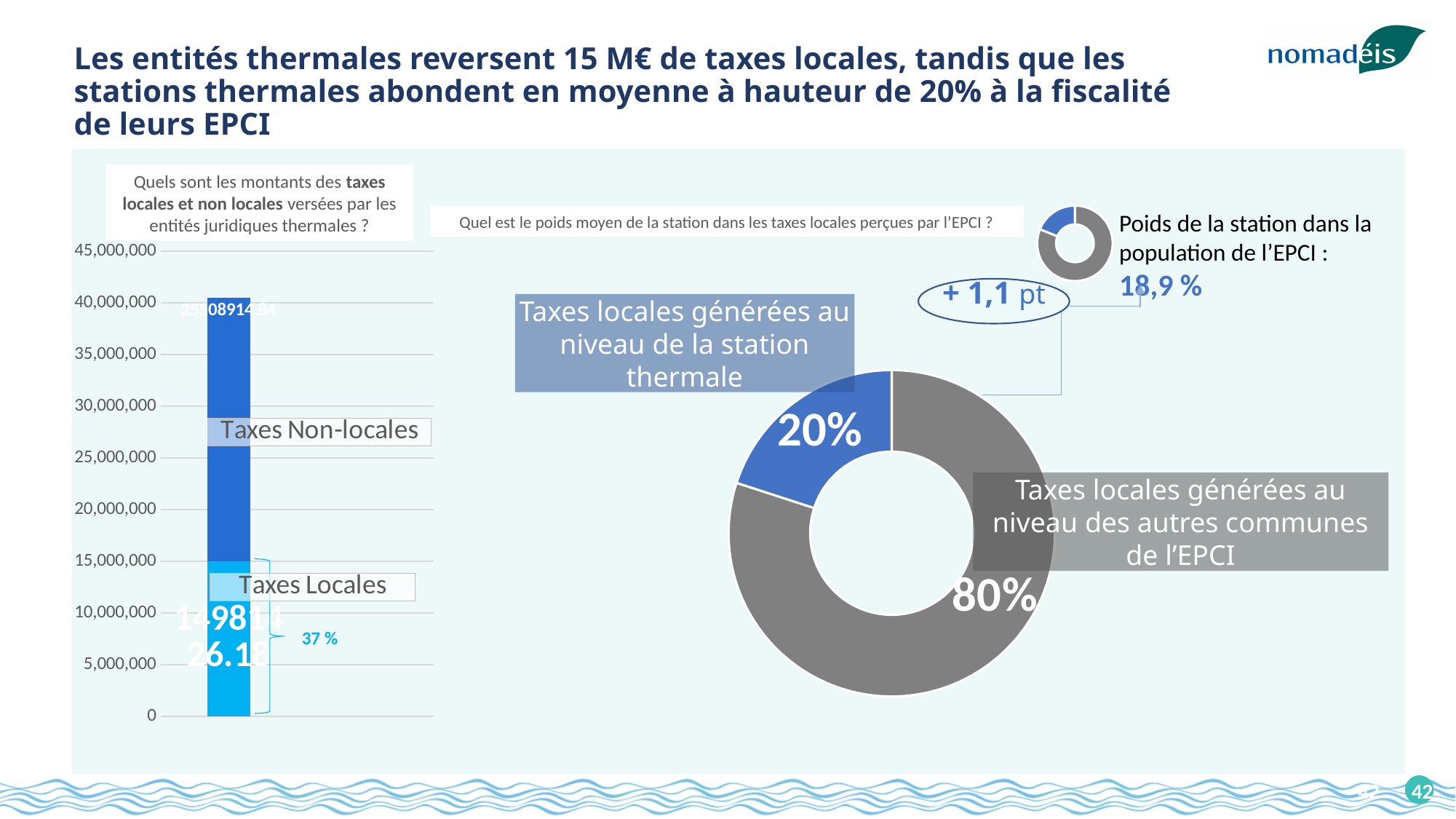
How many slices does the large donut chart on the right have? 2 In the donut chart on the right, what share is labelled for 'Taxes locales générées au niveau de la station thermale'? 20% In the bar chart on the left, is the total height of the stacked bar greater or less than 35,000,000? greater According to the small donut chart at the top right, what is the 'Poids de la station dans la population de l'EPCI'? 18,9 % In the donut chart on the right, what share is labelled for 'Taxes locales générées au niveau des autres communes de l'EPCI'? 80% What kind of chart is the large chart on the right of the slide showing 20% and 80%? donut (pie) chart In the donut chart on the right, what is the difference in percentage points between the 80% slice and the 20% slice? 60 points In the bar chart on the left, which segment is larger: Taxes Non-locales or Taxes Locales? Taxes Non-locales In the bar chart on the left, how many series are stacked in the bar? 2 In the donut chart on the right, which slice is larger: the station thermale slice or the autres communes de l'EPCI slice? autres communes de l'EPCI What kind of chart is the chart on the left of the slide? bar chart In the bar chart on the left, is the value for Taxes Locales greater or less than 10,000,000? greater